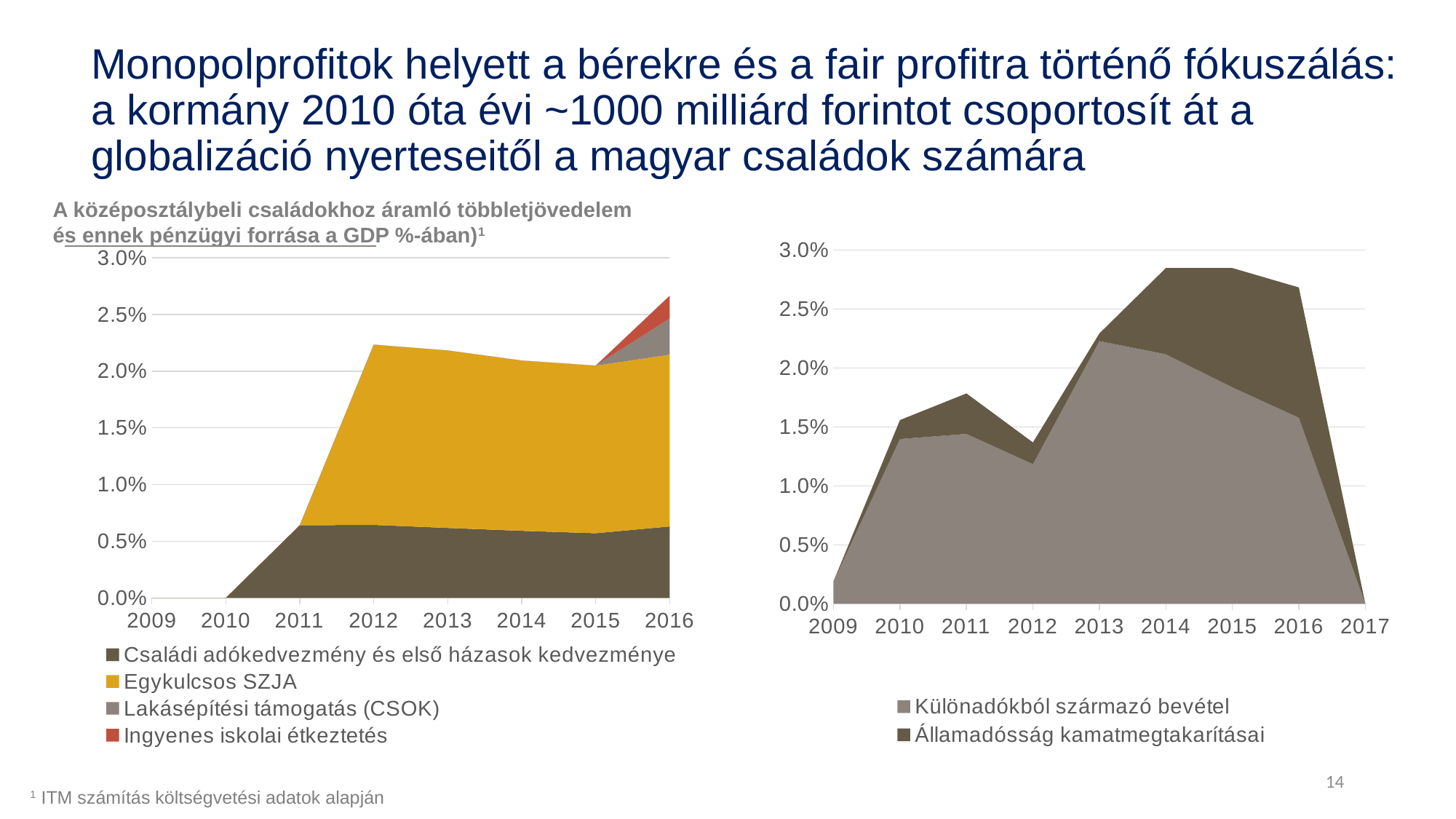
In the right chart, is the total value for 2012 greater or less than 1.5%? less In the left chart, is the total value for 2016 greater or less than 2.5%? greater In the right chart, is the total value for 2014 greater or less than 2.5%? greater In the right chart, which series is shown in the darker brown colour? Államadósság kamatmegtakarításai In the left chart, which year has the highest total value? 2016 In the left chart, which series is shown in yellow? Egykulcsos SZJA How many years are shown on the x axis of the right chart? 9 In the right chart, do the total values rise or fall from 2015 to 2017? fall How many series does the legend of the right chart list? 2 How many series does the legend of the left chart list? 4 What kind of chart is the left chart on the slide? stacked area chart